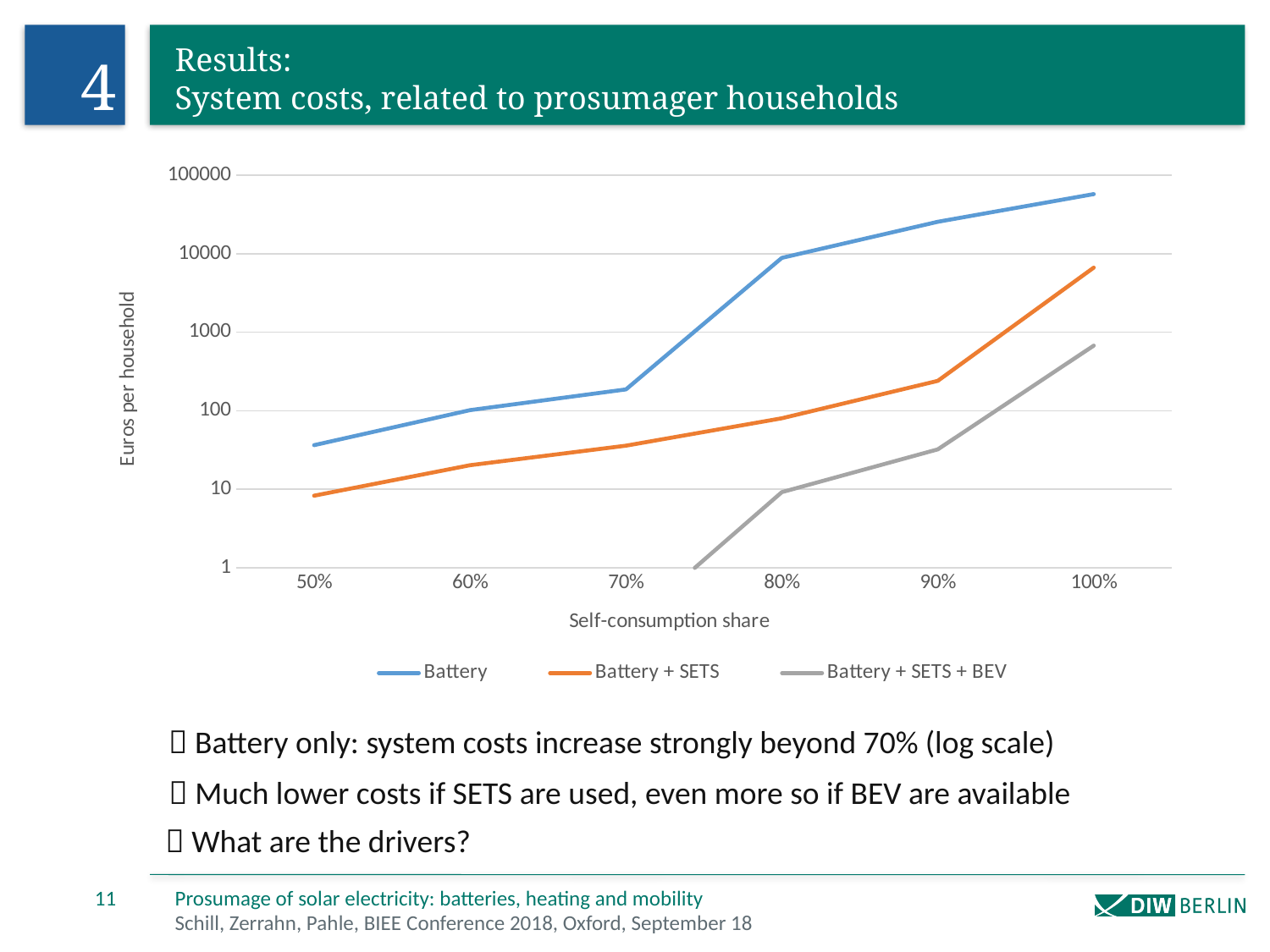
How many series does the legend list? 3 Is the value for Battery + SETS at a self-consumption share of 50% greater or less than 10? less Which series has the highest value at a self-consumption share of 100%? Battery How many self-consumption share categories are shown on the x axis? 6 What is the label of the y axis? Euros per household At a self-consumption share of 80%, which is larger: Battery or Battery + SETS? Battery Do the values for the Battery series rise or fall as the self-consumption share increases? rise Is the value for Battery at a self-consumption share of 100% greater or less than 10000? greater Which series has the lowest value at a self-consumption share of 100%? Battery + SETS + BEV What kind of chart is shown on the slide? line chart Is the value for Battery at a self-consumption share of 70% greater or less than 100? greater